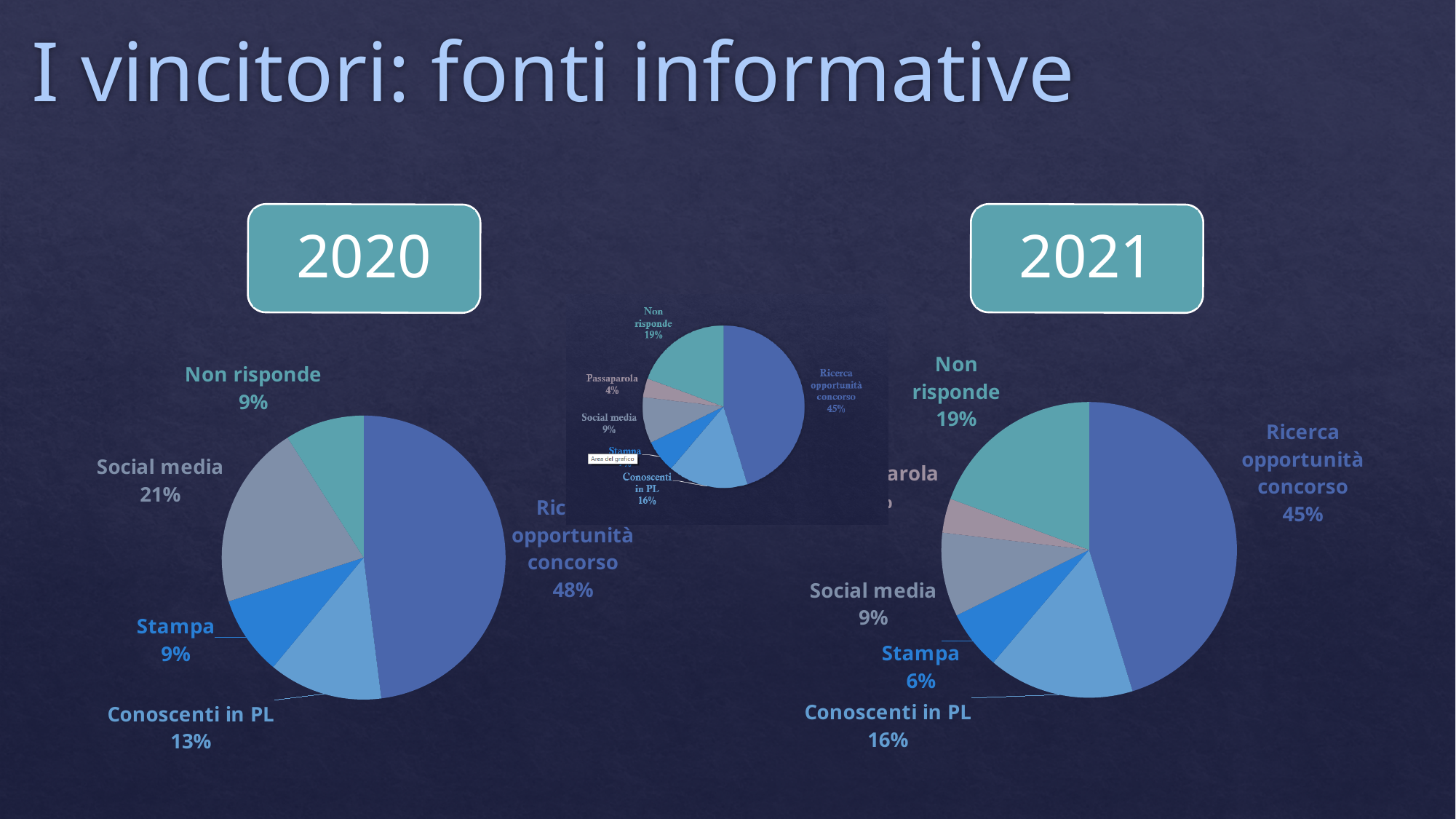
In the 2020 pie chart, what percentage is shown for Conoscenti in PL? 13% In the 2020 pie chart, how many percentage points larger is Social media than Conoscenti in PL? 8 How many slices does the 2020 pie chart have? 5 In the 2020 pie chart, which category has the largest slice? Ricerca opportunità concorso In the 2021 pie chart, what percentage is shown for Non risponde? 19% What is the title of the slide? I vincitori: fonti informative In the 2021 pie chart, what percentage is shown for Stampa? 6% In the 2021 pie chart, which category has the largest slice? Ricerca opportunità concorso Is the Social media share larger in the 2020 pie chart or the 2021 pie chart? 2020 In the 2020 pie chart, what percentage is shown for Social media? 21% In the 2021 pie chart, what is the difference in percentage points between Non risponde and Stampa? 13 What type of chart is used for the 2021 data? Pie chart